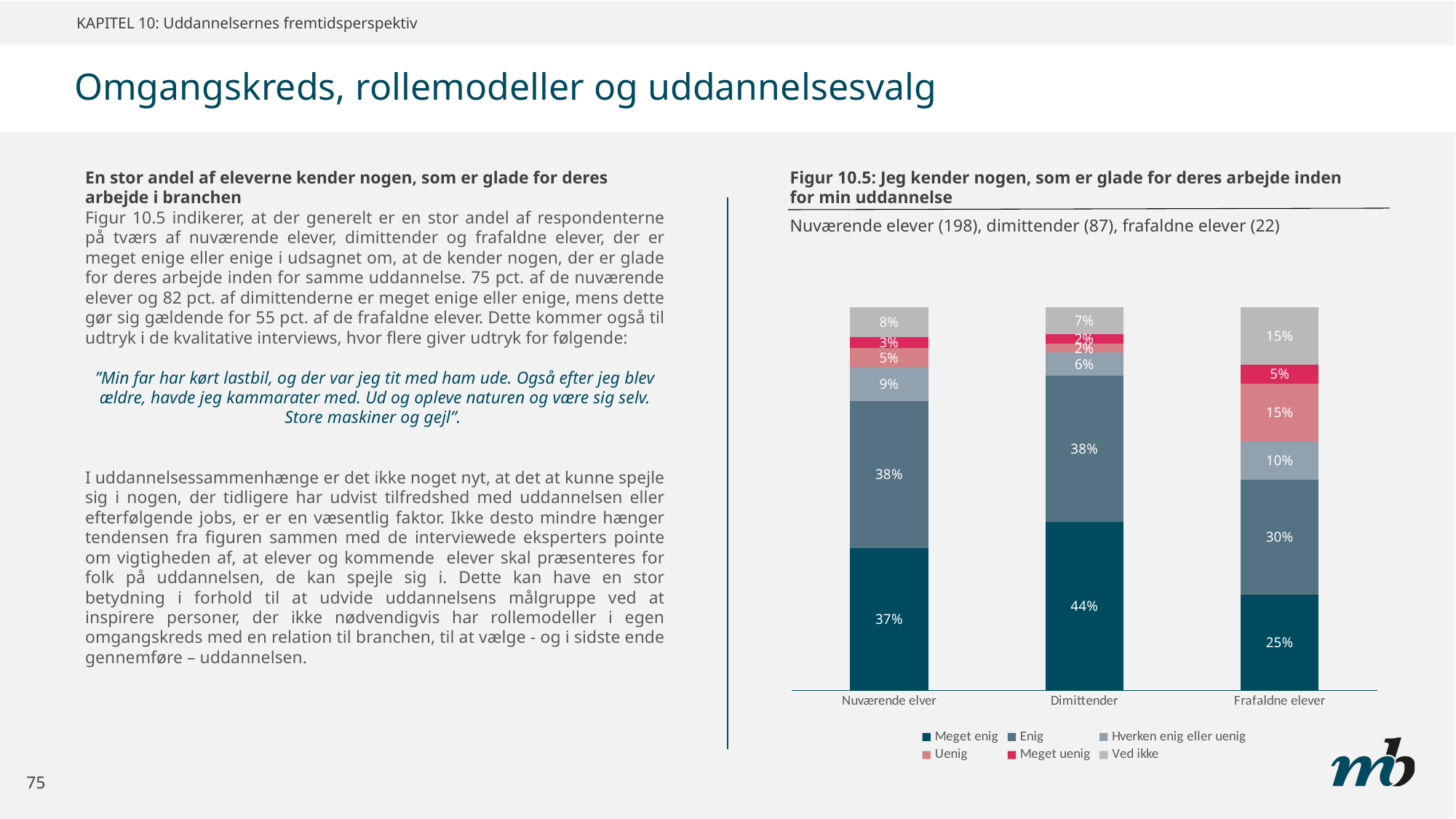
What type of chart is shown in Figur 10.5? Stacked bar chart How many categories are shown on the x axis of the chart? 3 What is the 'Uenig' share for Frafaldne elever? 15% Which category has the highest 'Meget enig' share? Dimittender How many series does the chart legend list? 6 What is the 'Ved ikke' share for Nuværende elver? 8% Which is larger: the 'Hverken enig eller uenig' share for Frafaldne elever or for Dimittender? Frafaldne elever Which category has the lowest 'Meget enig' share? Frafaldne elever What is the difference between the 'Meget enig' share for Dimittender and for Nuværende elver? 7% What is the total of the stacked bar for Frafaldne elever? 100% What is the 'Meget enig' share for Dimittender? 44% What is the 'Enig' share for Frafaldne elever? 30%